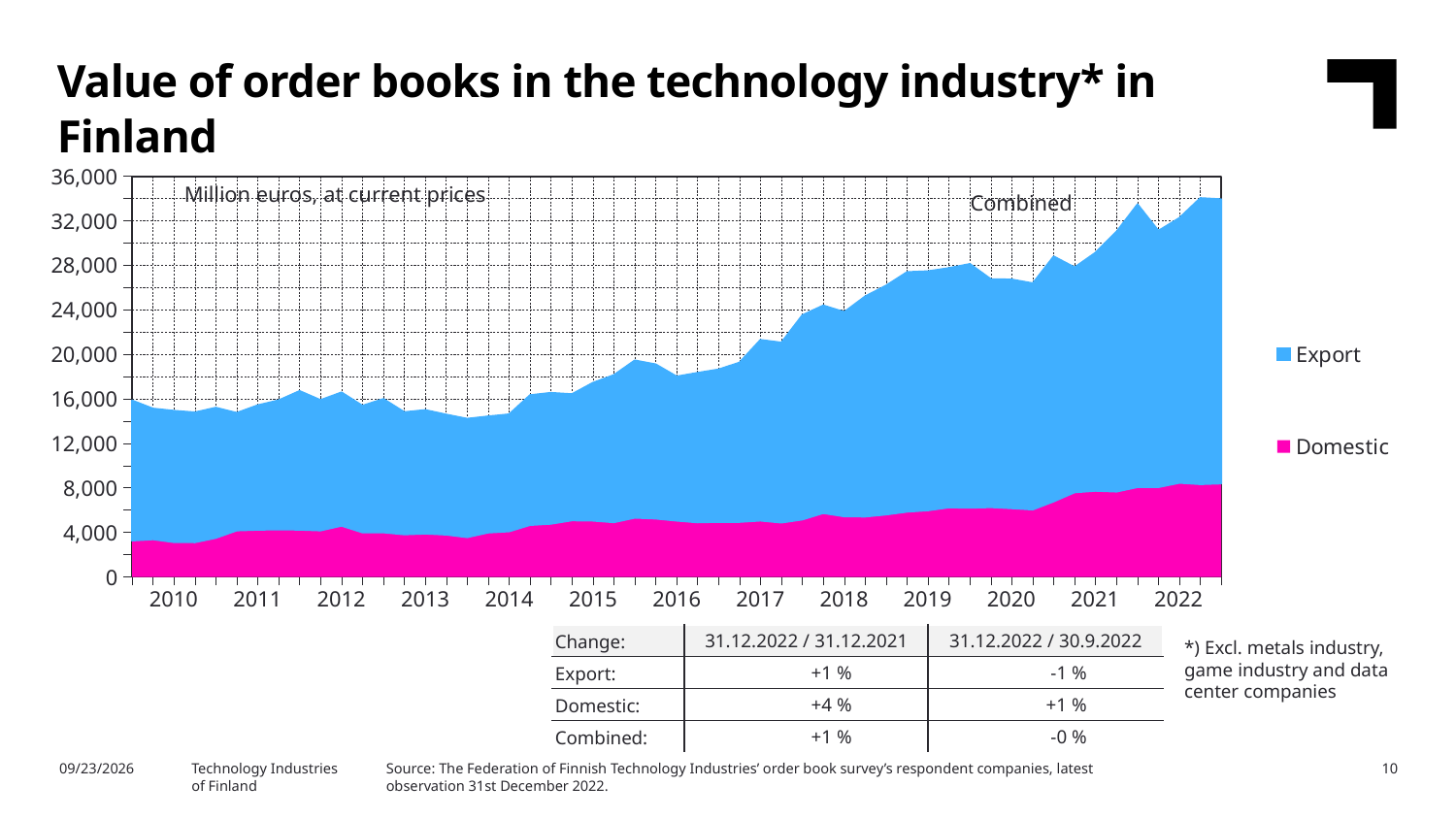
In what unit are the values in the chart expressed? Million euros, at current prices According to the table, what is the change in Domestic order books between 31.12.2021 and 31.12.2022? +4 % What kind of chart is shown on the slide? Stacked area chart Is the combined value of order books at the start of 2010 greater or less than 20,000? less Is the Domestic value of order books at the start of 2010 greater or less than 4,000? less Is the combined value of order books at the end of 2022 greater or less than 32,000? greater How many years are labelled on the x axis of the chart? 13 How many series does the chart legend list? 2 Which two series are shown in the chart legend? Export and Domestic According to the table, what is the change in Combined order books between 31.12.2021 and 31.12.2022? +1 % According to the table, what is the change in Export order books between 30.9.2022 and 31.12.2022? -1 % Does the combined value of order books generally rise or fall from 2010 to 2022? Rise